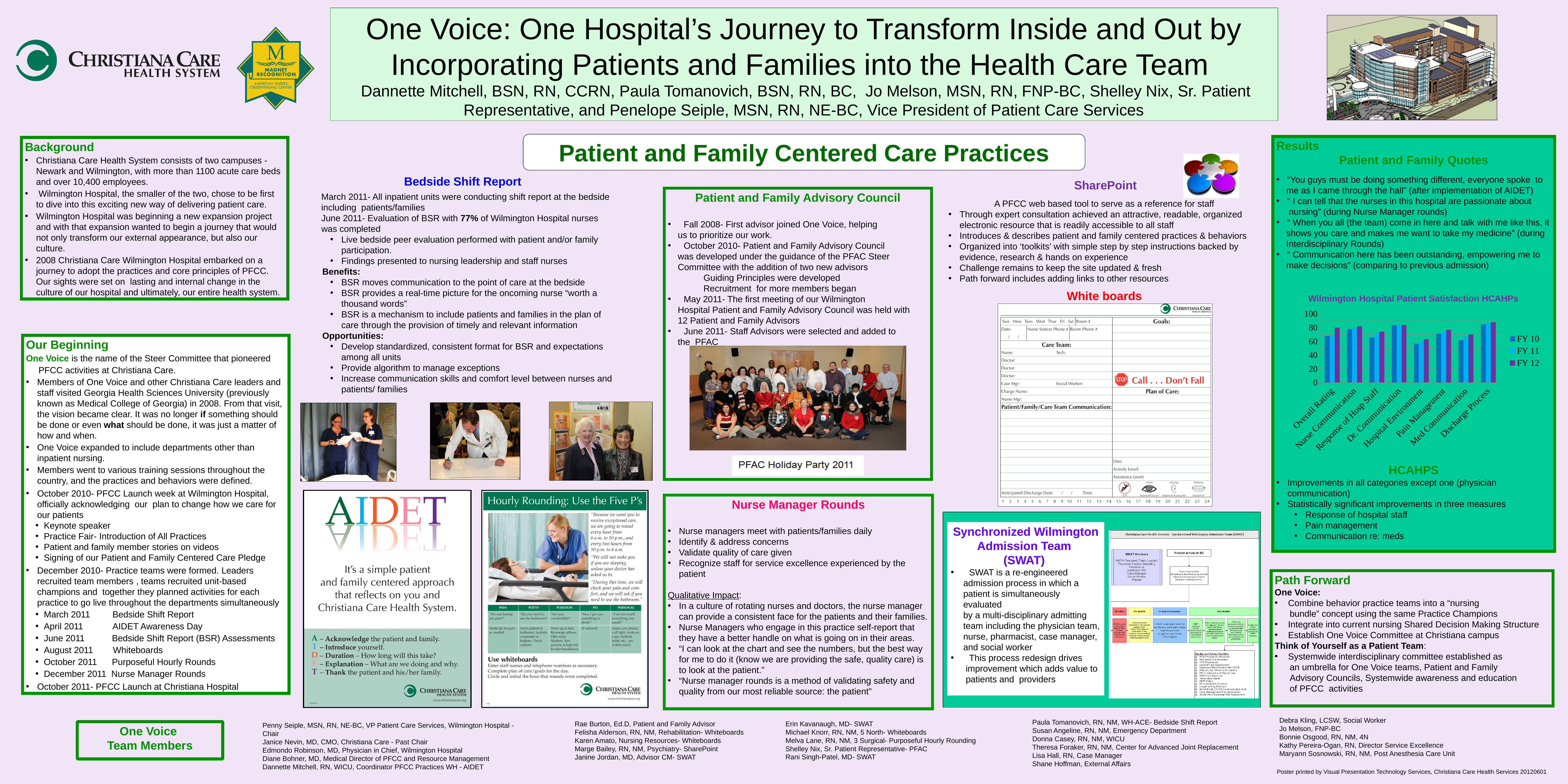
How many categories are shown on the x axis of the Wilmington Hospital Patient Satisfaction HCAHPS chart? 8 In the Wilmington Hospital Patient Satisfaction HCAHPS chart, is the FY 11 value for Discharge Process greater or less than 60? greater In the Wilmington Hospital Patient Satisfaction HCAHPS chart, is the FY 10 value for Hospital Environment greater or less than 80? less In the Wilmington Hospital Patient Satisfaction HCAHPS chart, is the FY 10 value for Med Communication greater or less than 80? less What kind of chart is the Wilmington Hospital Patient Satisfaction HCAHPS chart? bar chart What is the title of the bar chart in the Results section? Wilmington Hospital Patient Satisfaction HCAHPs How many series does the legend of the Wilmington Hospital Patient Satisfaction HCAHPS chart list? 3 What are the legend entries of the Wilmington Hospital Patient Satisfaction HCAHPS chart? FY 10, FY 11, FY 12 What is the highest value shown on the y axis of the Wilmington Hospital Patient Satisfaction HCAHPS chart? 100